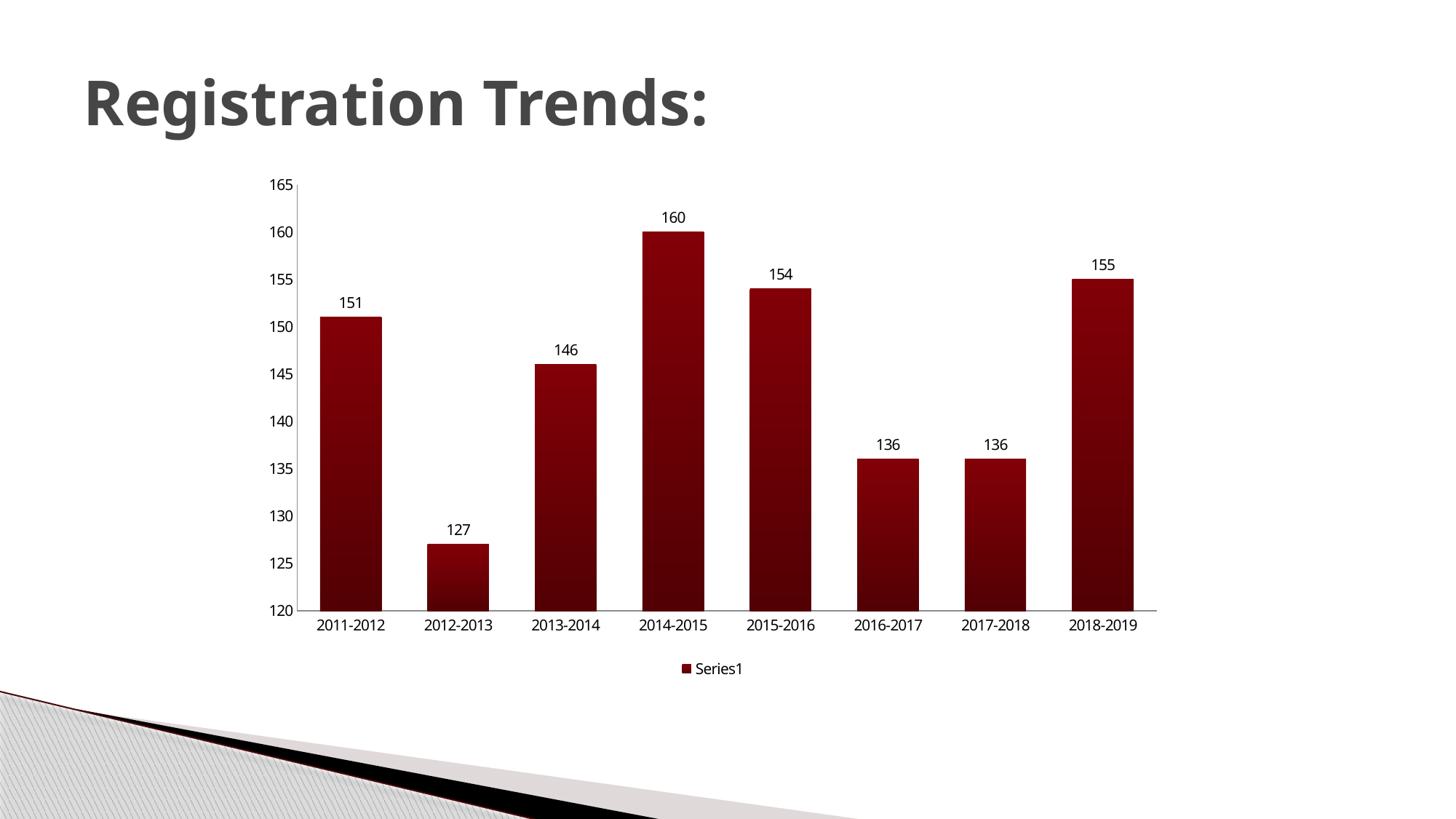
What is the value for 2014-2015? 160 Which is larger, the value for 2011-2012 or the value for 2013-2014? 2011-2012 Is the value for 2015-2016 greater or less than 150? greater Which year has the highest value? 2014-2015 How many years are shown on the x axis? 8 What is the value for 2012-2013? 127 What kind of chart is shown on the slide? bar chart What is the title of the slide? Registration Trends: What is the difference between the values for 2018-2019 and 2017-2018? 19 Which year has the lowest value? 2012-2013 What is the value for 2018-2019? 155 What is the difference between the values for 2014-2015 and 2012-2013? 33